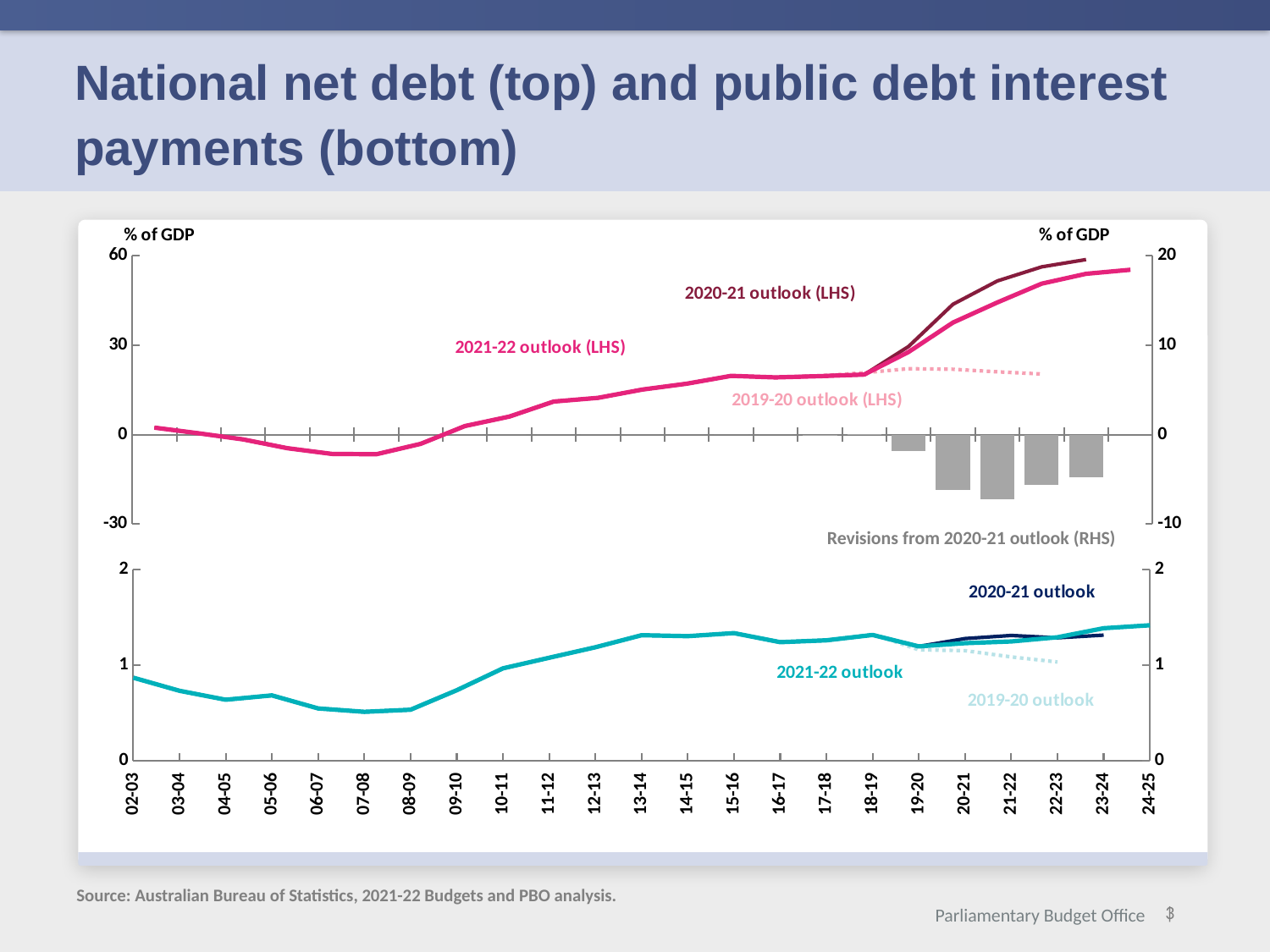
On the top chart, is the value of the 2021-22 outlook (LHS) line for 24-25 greater or less than 30? greater On the bottom chart, is the value of the 2021-22 outlook line for 13-14 greater or less than 1? greater How many financial years are labelled along the x axis? 23 On the top chart, does the 2021-22 outlook (LHS) line rise or fall from 08-09 to 24-25? rise What unit is shown on the left axis label of the top chart? % of GDP On the top chart, how many grey bars for Revisions from 2020-21 outlook (RHS) are shown? 5 On the bottom chart, is the value of the 2021-22 outlook line for 07-08 greater or less than 1? less On the top chart, which is higher at 23-24: the 2020-21 outlook (LHS) line or the 2021-22 outlook (LHS) line? 2020-21 outlook (LHS) On the top chart, which year has the lowest (most negative) bar for Revisions from 2020-21 outlook (RHS)? 21-22 On the bottom chart, does the 2021-22 outlook line rise or fall from 02-03 to 07-08? fall